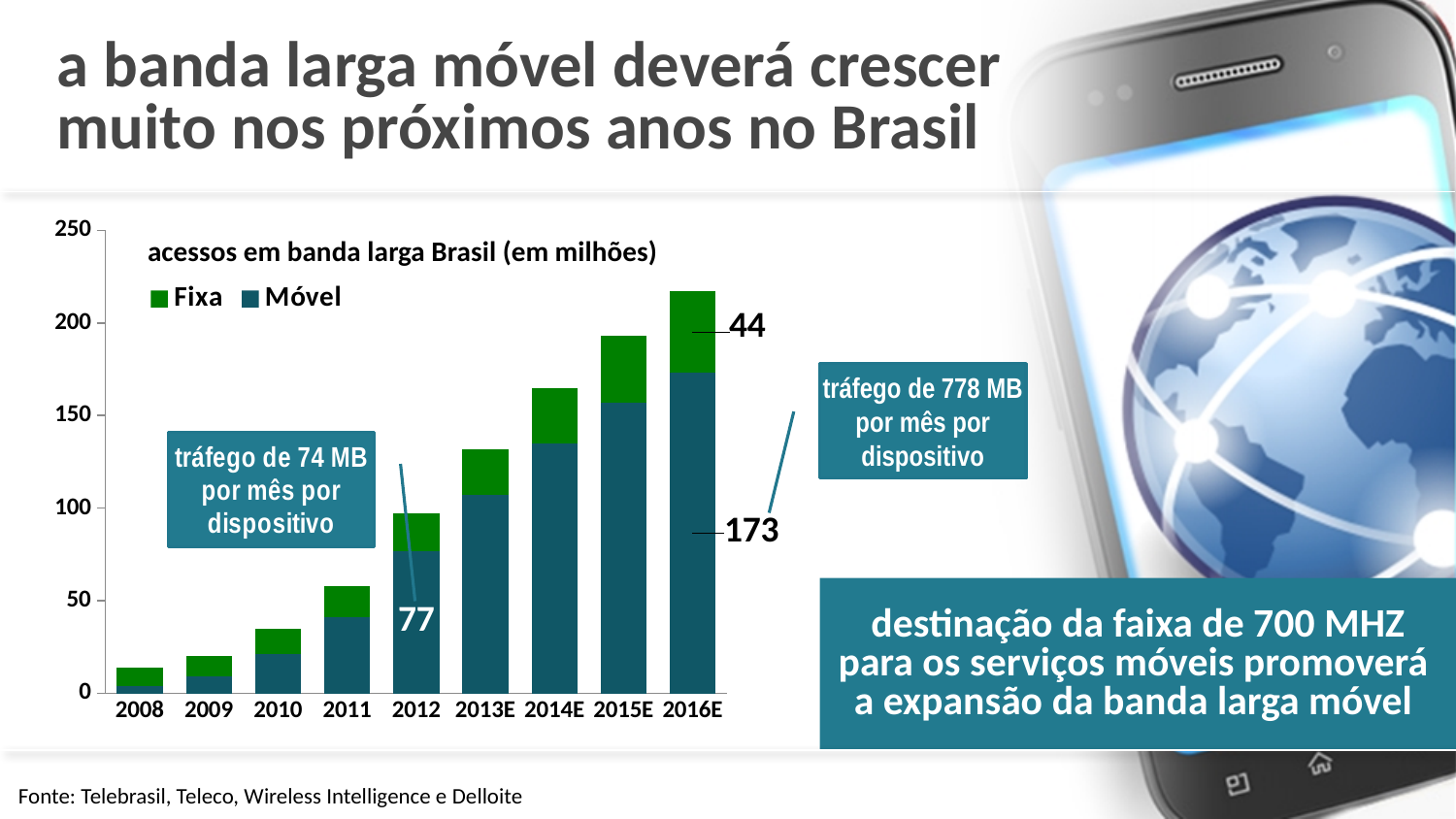
What kind of chart is shown on the slide? stacked bar chart Do the total values rise or fall from 2008 to 2016E? rise What is the total of the stacked bar for 2016E? 217 How many series does the chart legend list? 2 What is the title of the chart? acessos em banda larga Brasil (em milhões) What is the difference between the Móvel values for 2016E and 2012? 96 How many years are shown on the x axis of the chart? 9 Which year has the highest total bar? 2016E Which year has the lowest total bar? 2008 What is the value of Móvel in 2012? 77 What is the value of Móvel in 2016E? 173 What is the value of Fixa in 2016E? 44